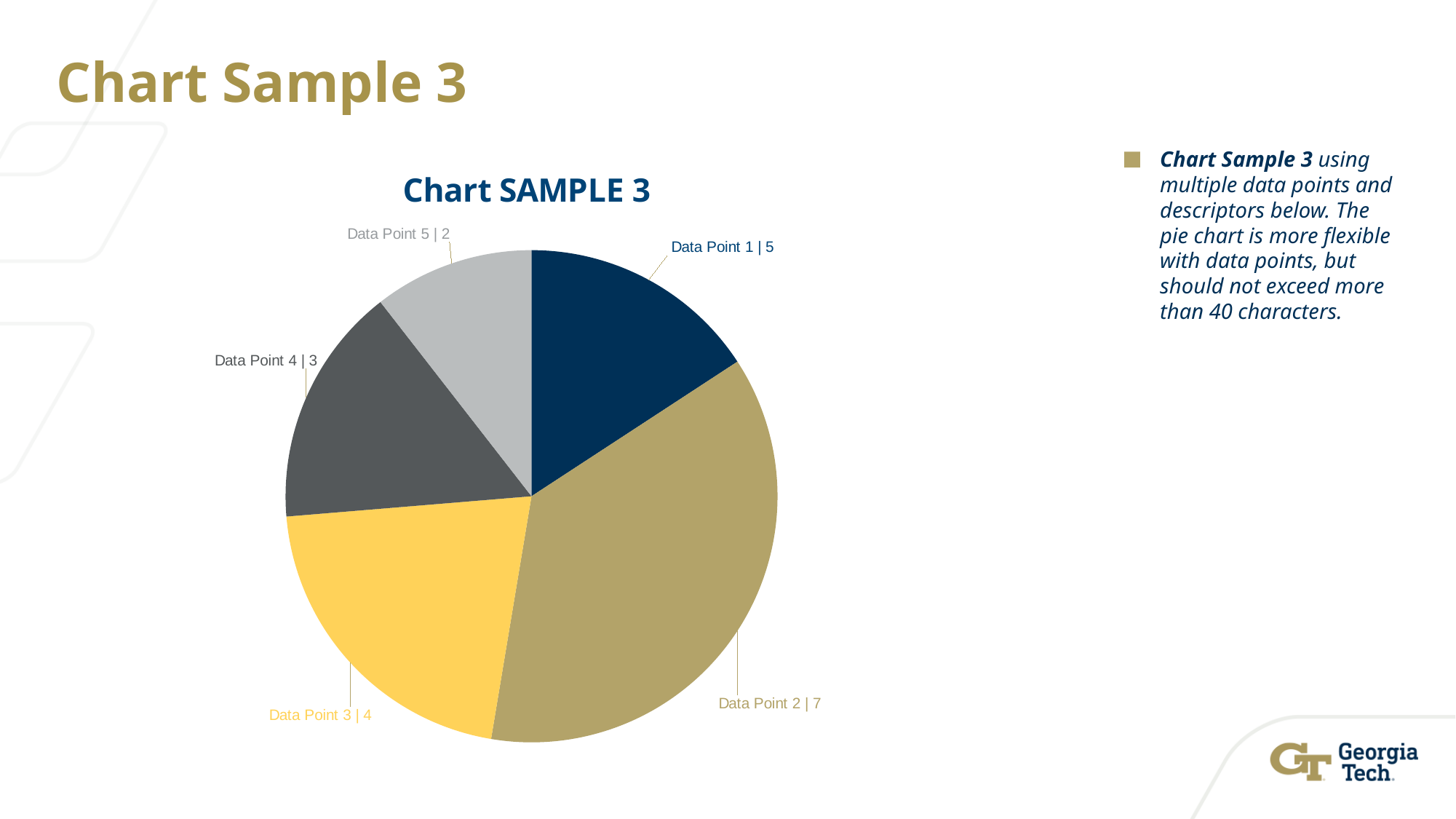
How many data points are shown in the pie chart? 5 What is the value for Data Point 3? 4 What is the value for Data Point 5? 2 What is the title of the chart? Chart SAMPLE 3 What kind of chart is shown on the slide? Pie chart Which data point has the smallest slice of the pie? Data Point 5 Which data point has the largest slice of the pie? Data Point 2 What is the difference between the values of Data Point 2 and Data Point 4? 4 What is the value for Data Point 2? 7